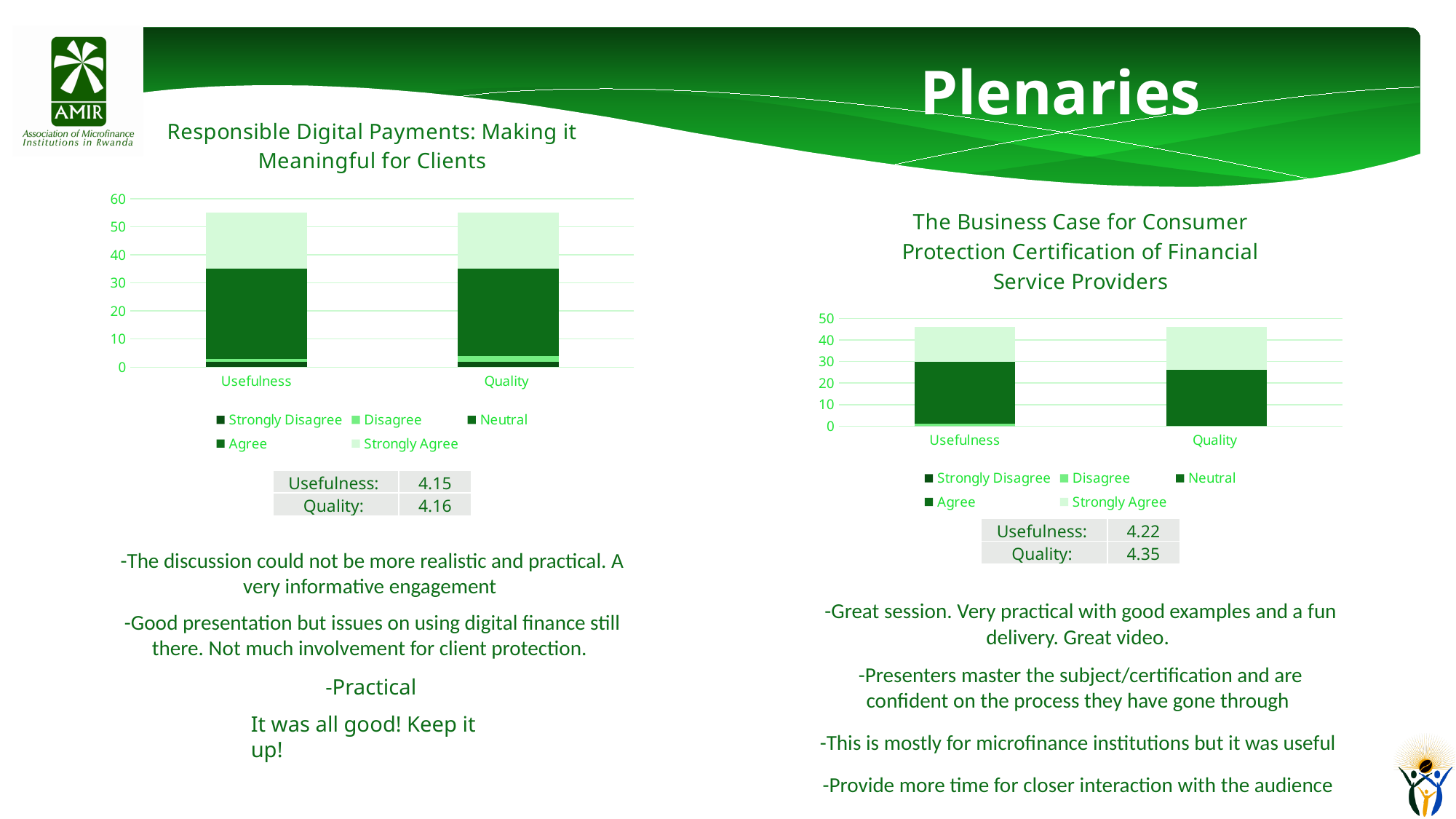
In 'The Business Case for Consumer Protection Certification' chart, is the Agree segment of the Quality bar greater or less than 30? less What kind of chart is shown under the title 'The Business Case for Consumer Protection Certification of Financial Service Providers'? Stacked bar chart In 'The Business Case for Consumer Protection Certification' chart, which category has the larger Agree segment, Usefulness or Quality? Usefulness How many series does the legend of 'The Business Case for Consumer Protection Certification' chart list? 5 What is the highest value shown on the y axis of the 'Responsible Digital Payments' chart? 60 How many series does the legend of the 'Responsible Digital Payments' chart list? 5 How many categories are shown on the x axis of the 'Responsible Digital Payments' chart? 2 In the 'Responsible Digital Payments' chart, is the total height of the Usefulness bar greater or less than 50? greater What kind of chart is shown under the title 'Responsible Digital Payments: Making it Meaningful for Clients'? Stacked bar chart In 'The Business Case for Consumer Protection Certification' chart, is the total height of the Quality bar greater or less than 40? greater Which legend entry in 'The Business Case for Consumer Protection Certification' chart is shown in the lightest green? Strongly Agree